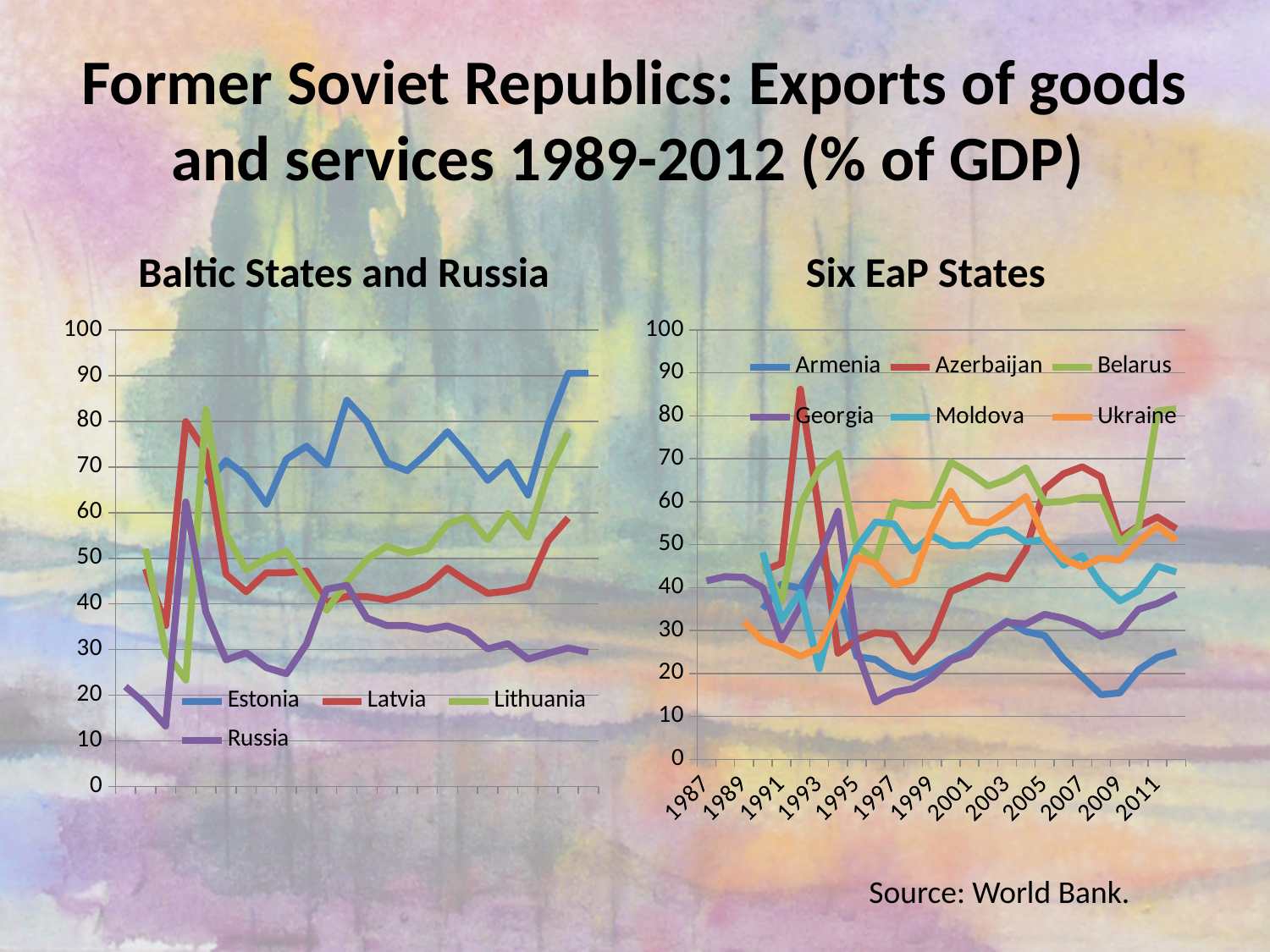
In the 'Baltic States and Russia' chart, which series has the lowest value at the right end of the chart? Russia In the 'Baltic States and Russia' chart, which series has the highest value at the right end of the chart? Estonia In the 'Six EaP States' chart, which series has the highest value at the right end of the chart? Belarus How many series does the legend of the 'Baltic States and Russia' chart list? 4 In the 'Baltic States and Russia' chart, is the final value for Russia greater or less than 40? less In the 'Six EaP States' chart, is the peak value for Azerbaijan around 1992 greater or less than 80? greater What kind of chart is the 'Baltic States and Russia' chart? line chart In the 'Baltic States and Russia' chart, is the final value for Estonia greater or less than 80? greater What is the first year label on the x axis of the 'Six EaP States' chart? 1987 How many series does the legend of the 'Six EaP States' chart list? 6 In the 'Six EaP States' chart, which is larger at the right end of the chart, Belarus or Armenia? Belarus